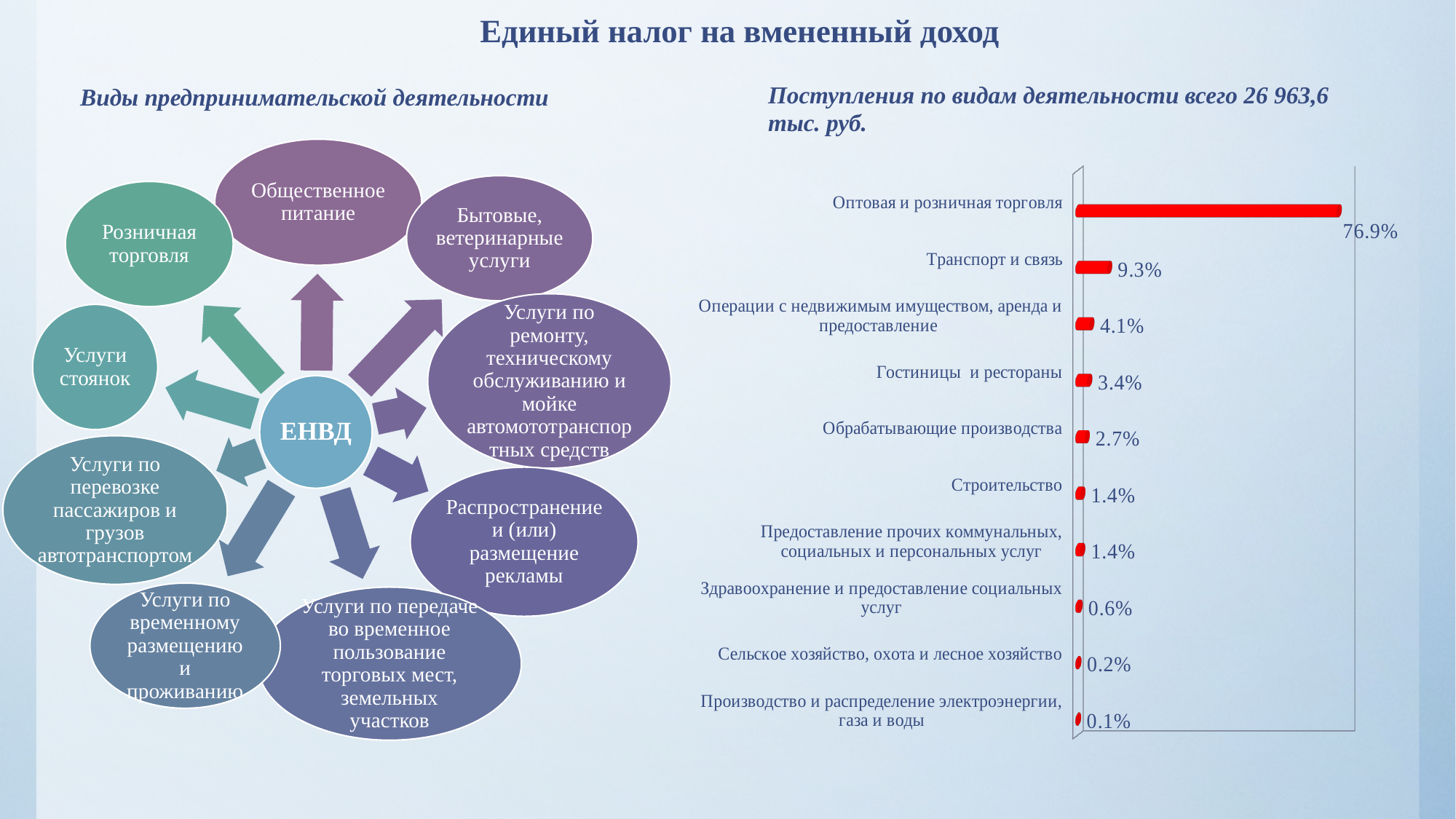
What is the value for Гостиницы и рестораны? 3.4% What is the value for Транспорт и связь? 9.3% What is the value for Оптовая и розничная торговля? 76.9% What total amount in thousand rubles is stated in the chart's title? 26 963,6 тыс. руб. Which is larger: the value for Гостиницы и рестораны or the value for Строительство? Гостиницы и рестораны Which category has the highest value in the chart? Оптовая и розничная торговля Which category has the lowest value in the chart? Производство и распределение электроэнергии, газа и воды What is the difference between the values for Оптовая и розничная торговля and Транспорт и связь? 67.6% What is the difference between the values for Операции с недвижимым имуществом, аренда и предоставление and Обрабатывающие производства? 1.4% What type of chart is used to show the revenue by type of activity? Bar chart How many categories are shown in the bar chart? 10 What is the value for Сельское хозяйство, охота и лесное хозяйство? 0.2%